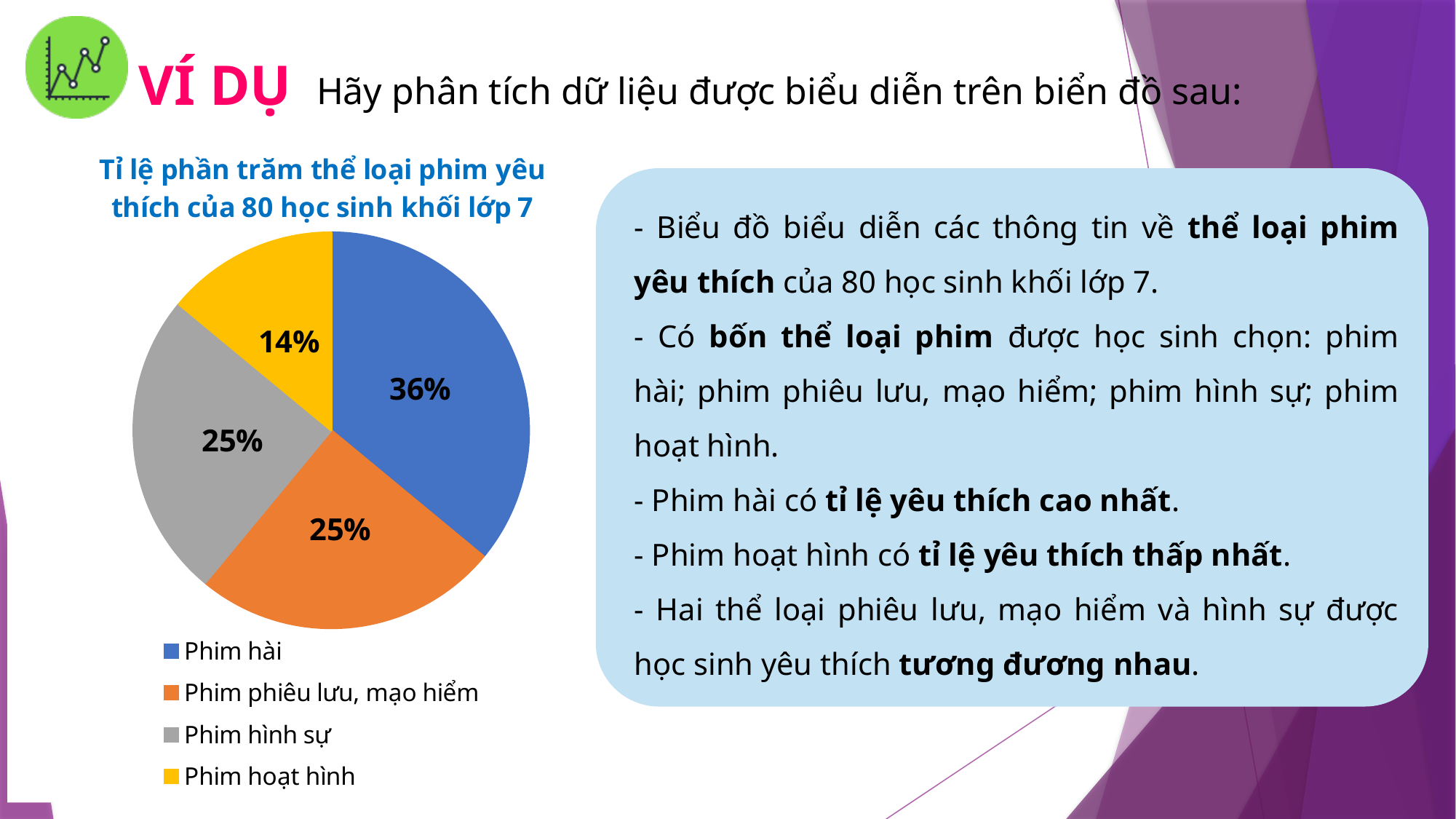
What is the title of the chart? Tỉ lệ phần trăm thể loại phim yêu thích của 80 học sinh khối lớp 7 Which film genre has the largest share of the pie? Phim hài What percentage of students chose Phim phiêu lưu, mạo hiểm? 25% What type of chart is shown on the slide? Pie chart Which is larger, the share for Phim hài or the share for Phim hình sự? Phim hài What percentage of students chose Phim hoạt hình? 14% What percentage of students chose Phim hình sự? 25% What colour is the slice for Phim hoạt hình? Yellow What is the difference in percentage points between Phim hài and Phim hoạt hình? 22 What percentage of students chose Phim hài? 36% Which film genre has the smallest share of the pie? Phim hoạt hình How many film genres are shown in the pie chart? 4